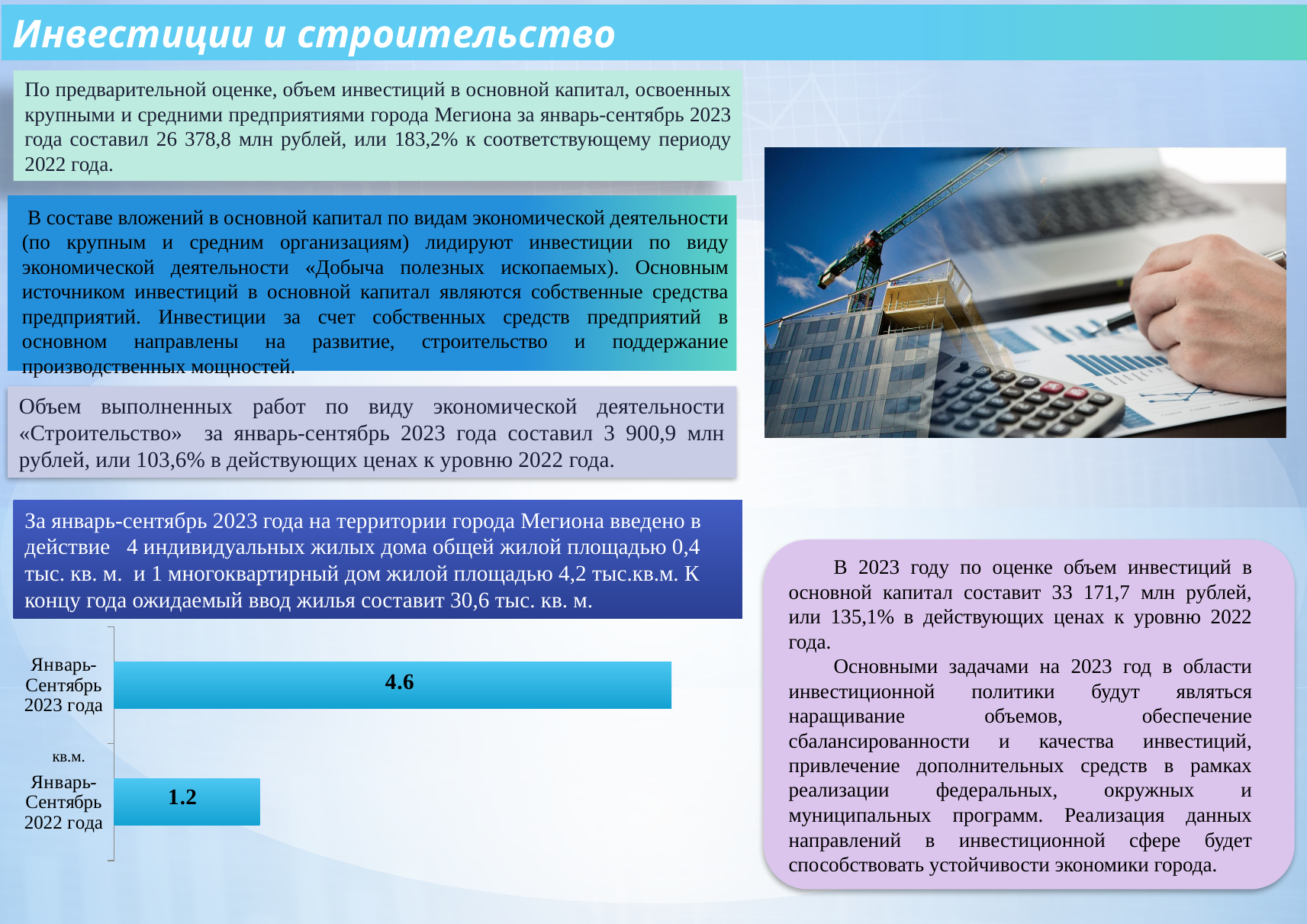
Which category has the lowest value in the bar chart? Январь-Сентябрь 2022 года What is the value for Январь-Сентябрь 2023 года in the bar chart? 4.6 Which is larger in the bar chart: the value for Январь-Сентябрь 2023 года or for Январь-Сентябрь 2022 года? Январь-Сентябрь 2023 года What kind of chart is shown on the slide? Bar chart Are the bars in the chart oriented horizontally or vertically? Horizontally What unit label is shown next to the category axis of the bar chart? кв.м. Which category has the highest value in the bar chart? Январь-Сентябрь 2023 года Do the values in the bar chart rise or fall from Январь-Сентябрь 2022 года to Январь-Сентябрь 2023 года? Rise What is the difference between the values for Январь-Сентябрь 2023 года and Январь-Сентябрь 2022 года in the bar chart? 3.4 How many categories are shown in the bar chart? 2 What is the value for Январь-Сентябрь 2022 года in the bar chart? 1.2